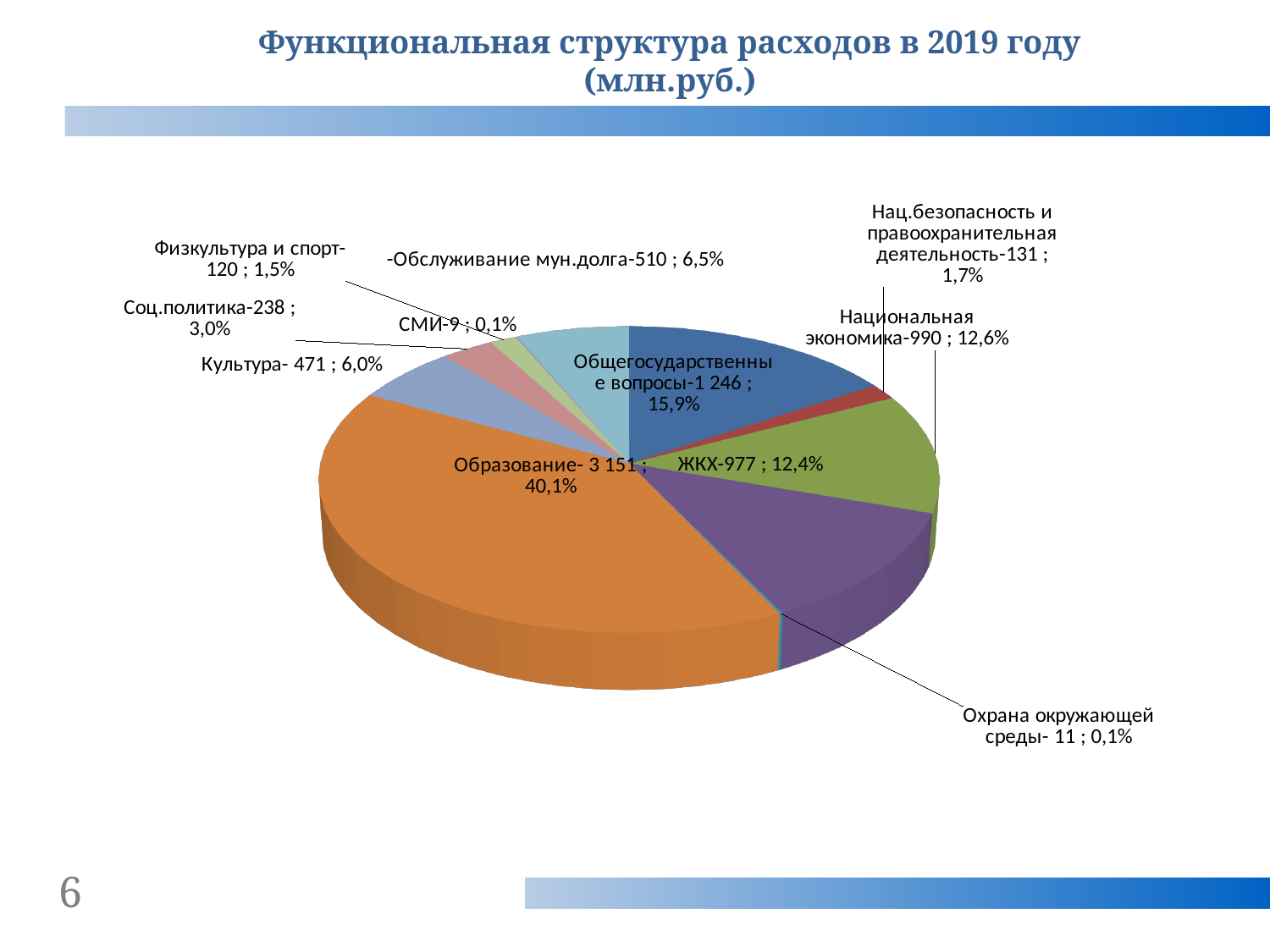
What is the title of the chart? Функциональная структура расходов в 2019 году (млн.руб.) What share of the pie does Образование represent? 40,1% Which category has the largest share of expenditures? Образование How many categories are shown in the pie chart? 11 What is the difference between the values for Национальная экономика and ЖКХ? 13 What is the value for Образование? 3 151 Which is larger, the value for Культура or the value for Соц.политика? Культура What is the value for Обслуживание мун.долга? 510 What kind of chart is shown on the slide? Pie chart What is the value for ЖКХ? 977 What is the value for Общегосударственные вопросы? 1 246 What share of the pie does Национальная экономика represent? 12,6%